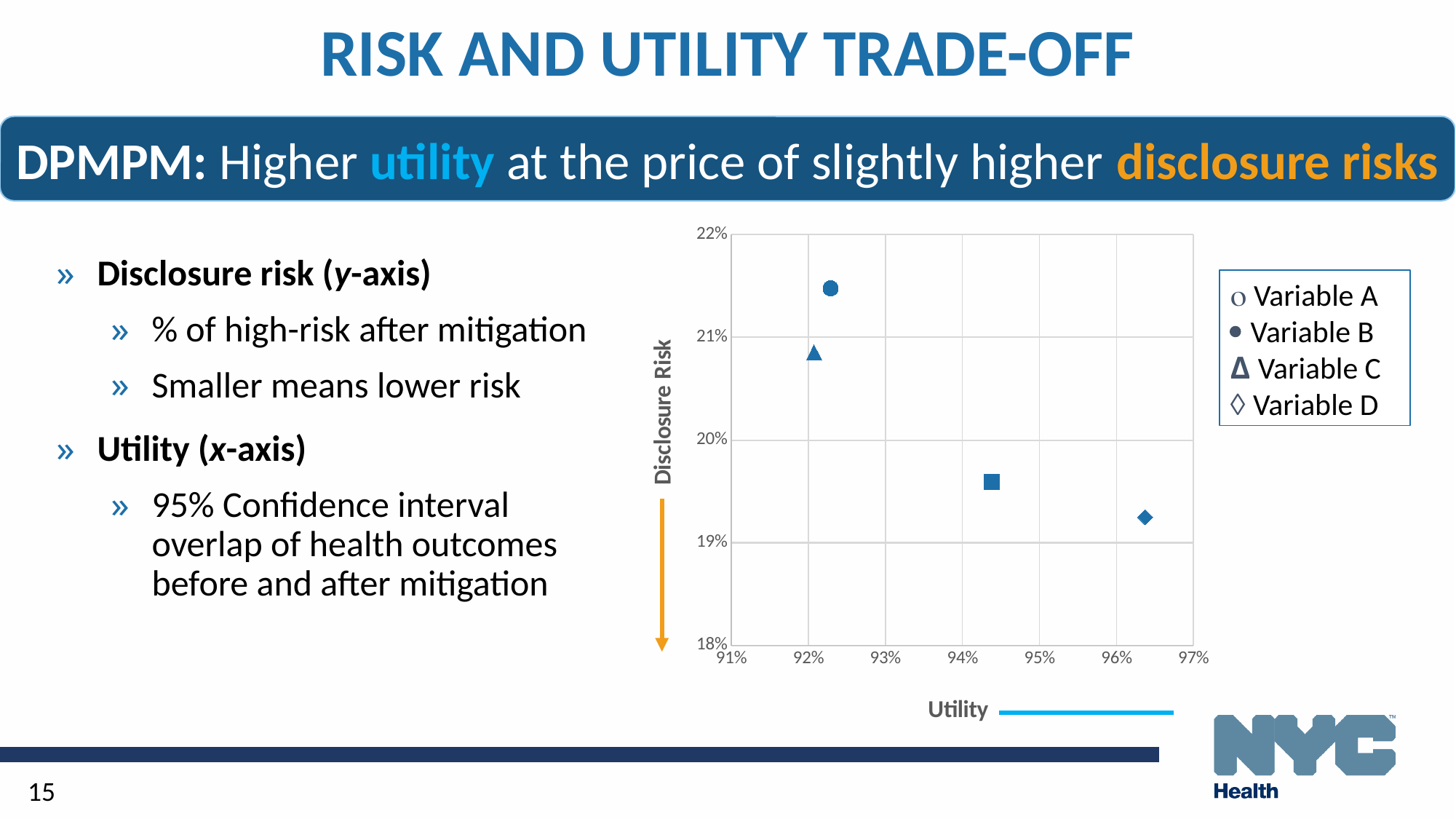
As utility increases along the x-axis, does disclosure risk generally rise or fall? Fall Is the disclosure risk for Variable B (the filled circle) greater or less than 21%? greater Is the disclosure risk for Variable C (the triangle) greater or less than 21%? less Which point has the lowest disclosure risk on the chart? Variable D (the diamond) What is the label on the chart's y-axis? Disclosure Risk How many series does the chart legend list? 4 Is the disclosure risk for Variable D (the diamond) greater or less than 19%? greater What kind of chart is shown on the slide? Scatter chart How many data points are plotted on the chart? 4 Which has the higher disclosure risk, Variable B or Variable C? Variable B